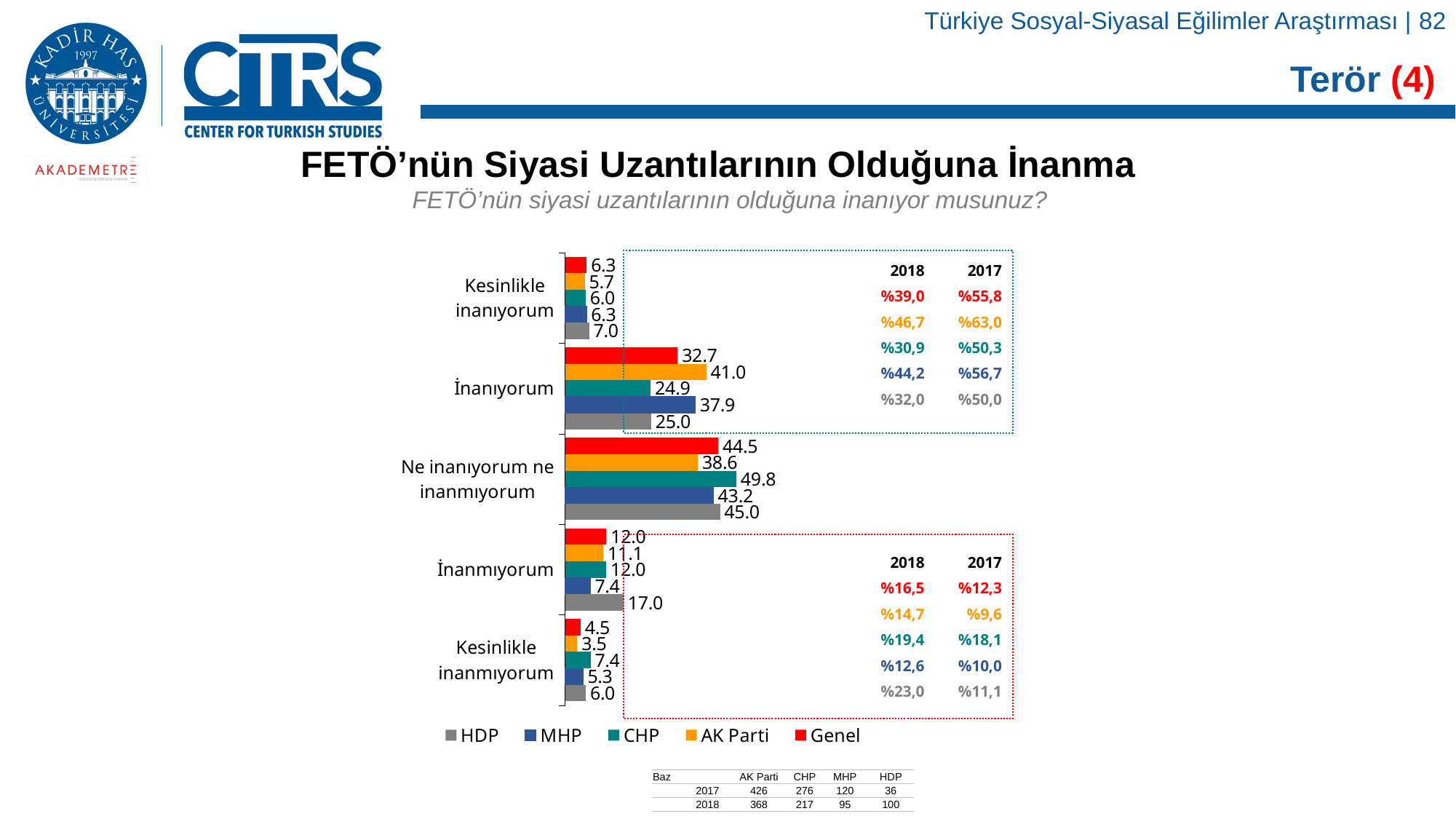
What type of chart is shown on the slide? bar chart Which series has the highest value in the 'İnanıyorum' category? AK Parti What is the value for Genel in the 'Kesinlikle inanmıyorum' category? 4.5 What is the value for HDP in the 'İnanmıyorum' category? 17.0 What is the value for CHP in the 'Ne inanıyorum ne inanmıyorum' category? 49.8 How many response categories are shown on the chart? 5 Which series has the lowest value in the 'Kesinlikle inanmıyorum' category? AK Parti What is the difference between the AK Parti and CHP values in the 'İnanıyorum' category? 16.1 How many series does the chart legend list? 5 In the 'İnanmıyorum' category, which is larger: the value for HDP or the value for MHP? HDP What is the value for AK Parti in the 'İnanıyorum' category? 41.0 Which series is shown in red in the chart legend? Genel